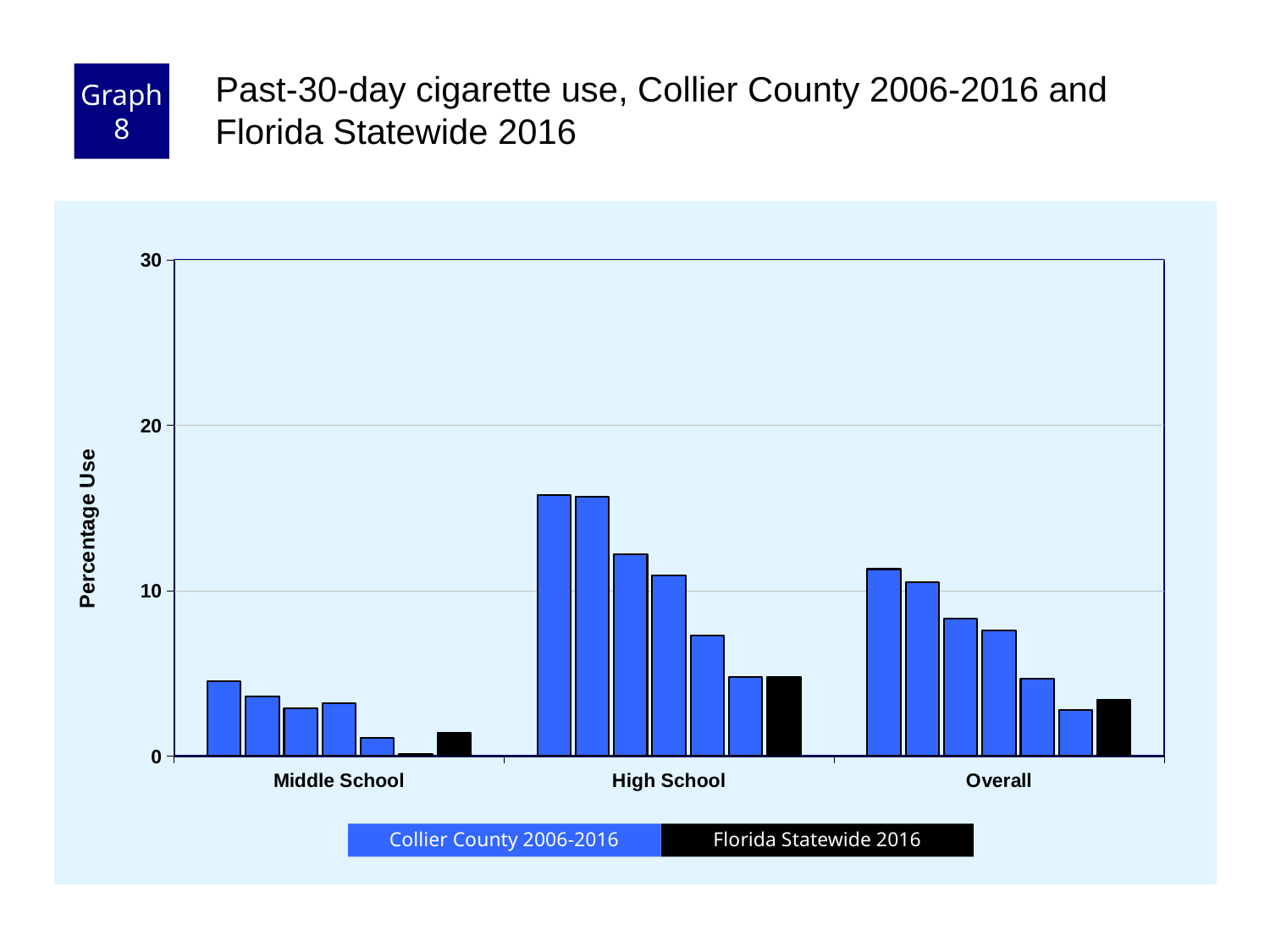
How many categories are shown on the x axis? 3 Is the Florida Statewide 2016 value for High School greater or less than 10? less Which category has the lowest bars? Middle School Which is larger, the Florida Statewide 2016 value for High School or for Middle School? High School What kind of chart is shown on the slide? bar chart What colour represents Florida Statewide 2016 in the legend? black Is the Florida Statewide 2016 value for Overall greater or less than 10? less Which category has the tallest bars? High School Is the tallest Collier County 2006-2016 bar for Middle School greater or less than 10? less How many series does the legend list? 2 Within the High School group, do the Collier County 2006-2016 bars rise or fall from left to right? fall